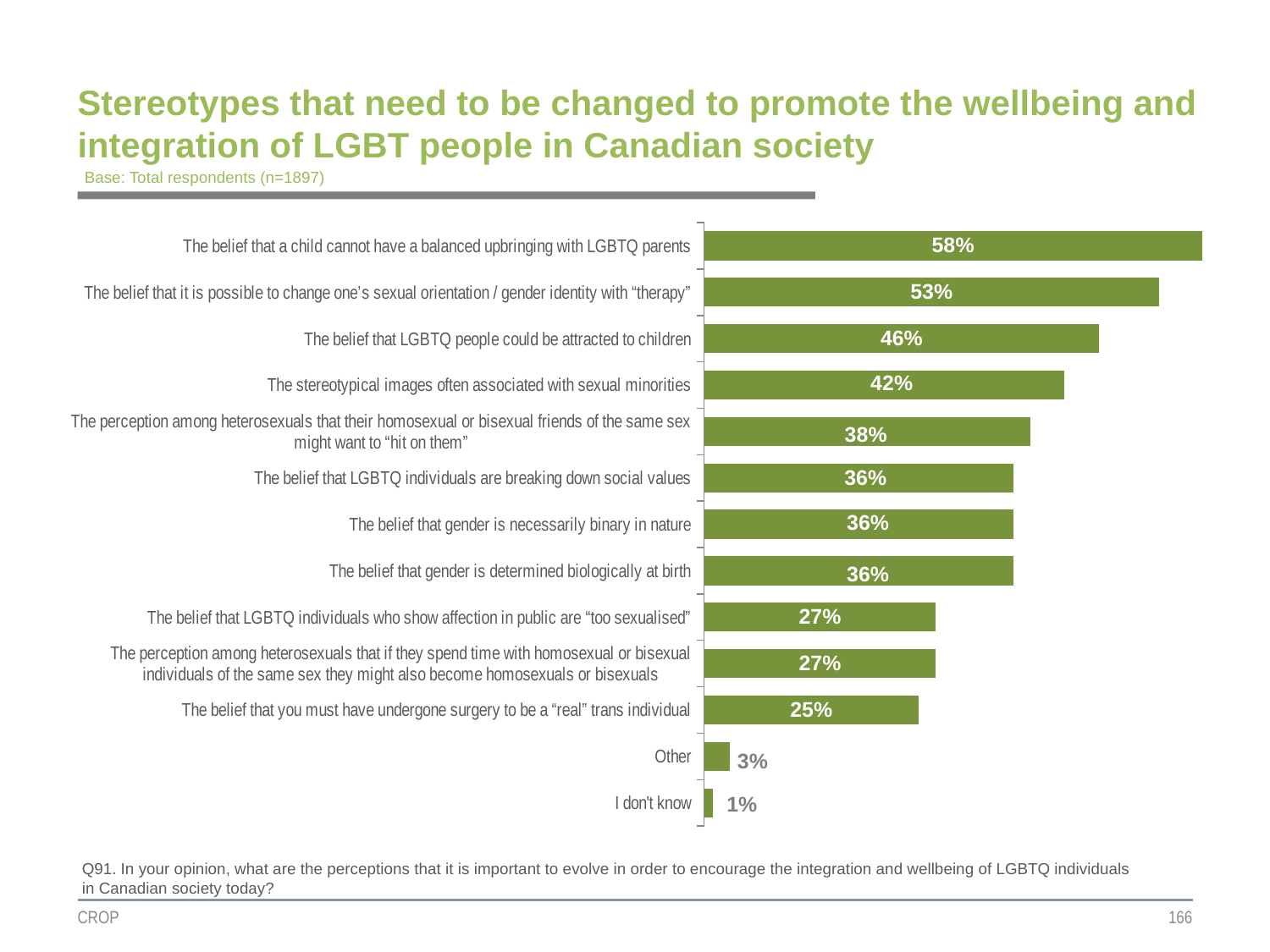
What percentage is shown for "The belief that you must have undergone surgery to be a "real" trans individual"? 25% What percentage of respondents selected "The belief that a child cannot have a balanced upbringing with LGBTQ parents"? 58% What is the difference between the value for "The belief that a child cannot have a balanced upbringing with LGBTQ parents" and the value for "The belief that it is possible to change one's sexual orientation / gender identity with "therapy""? 5% What is the value for "Other"? 3% What is the difference between the value for "The belief that gender is necessarily binary in nature" and the value for "The belief that LGBTQ individuals who show affection in public are "too sexualised""? 9% What is the value for "The belief that LGBTQ people could be attracted to children"? 46% Which category has the lowest value? I don't know Which category has the highest value? The belief that a child cannot have a balanced upbringing with LGBTQ parents What kind of chart is shown on the slide? Bar chart How many categories are shown in the chart? 13 What is the base (number of respondents) stated under the chart title? Total respondents (n=1897) Which is larger: the value for "The stereotypical images often associated with sexual minorities" or the value for "The belief that LGBTQ individuals are breaking down social values"? The stereotypical images often associated with sexual minorities